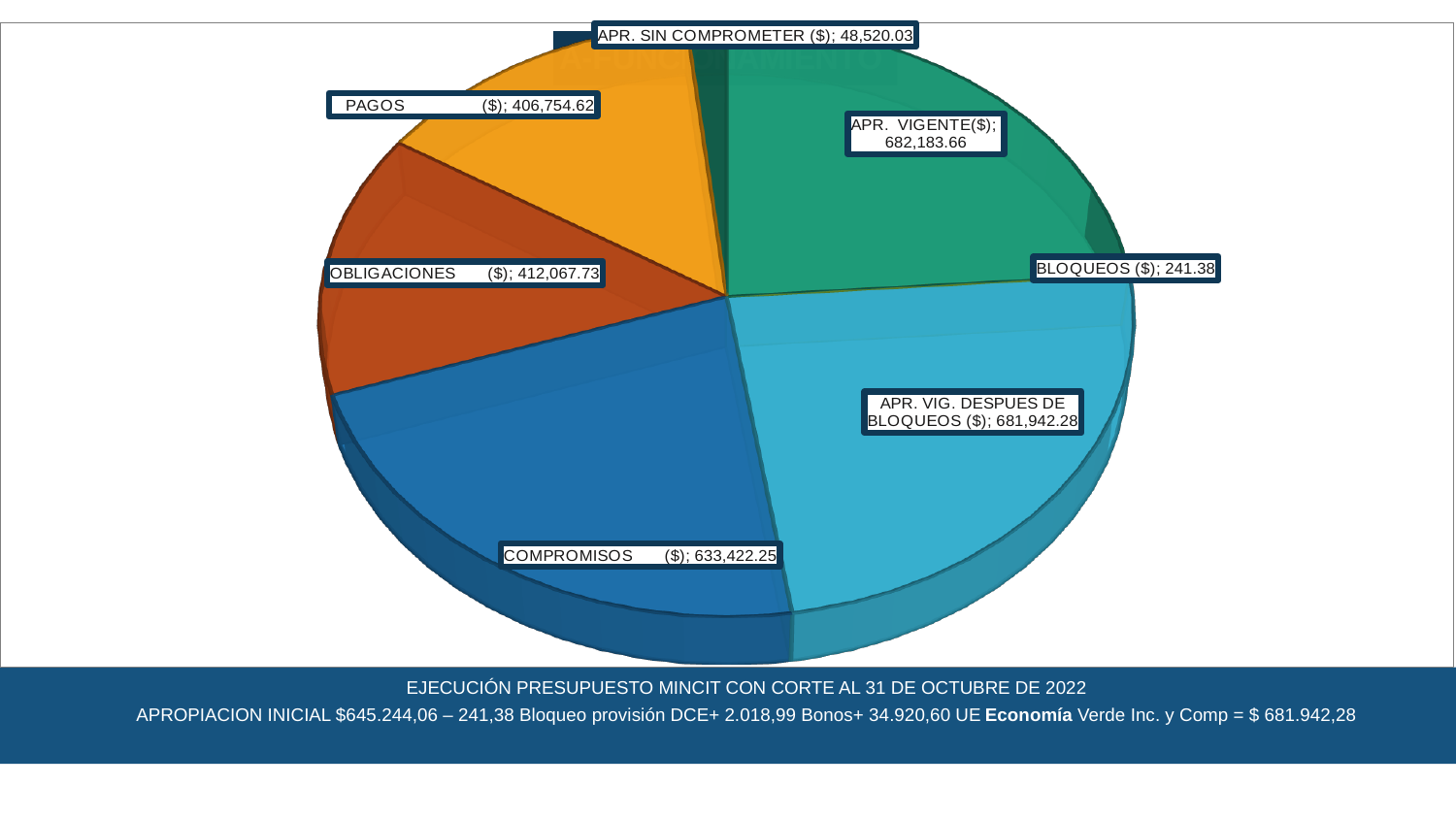
What is the difference between COMPROMISOS ($) and OBLIGACIONES ($) in the pie chart? 221,354.52 What kind of chart is shown on the slide? Pie chart What is the value shown for BLOQUEOS ($) in the pie chart? 241.38 Which is larger in the pie chart, COMPROMISOS ($) or OBLIGACIONES ($)? COMPROMISOS ($) What is the difference between OBLIGACIONES ($) and PAGOS ($) in the pie chart? 5,313.11 What is the value shown for APR. SIN COMPROMETER ($) in the pie chart? 48,520.03 What is the value shown for APR. VIGENTE ($) in the pie chart? 682,183.66 What is the value shown for PAGOS ($) in the pie chart? 406,754.62 What is the value shown for APR. VIG. DESPUES DE BLOQUEOS ($) in the pie chart? 681,942.28 How many slices does the pie chart have? 7 Which slice of the pie chart has the smallest value? BLOQUEOS ($) What is the value shown for COMPROMISOS ($) in the pie chart? 633,422.25